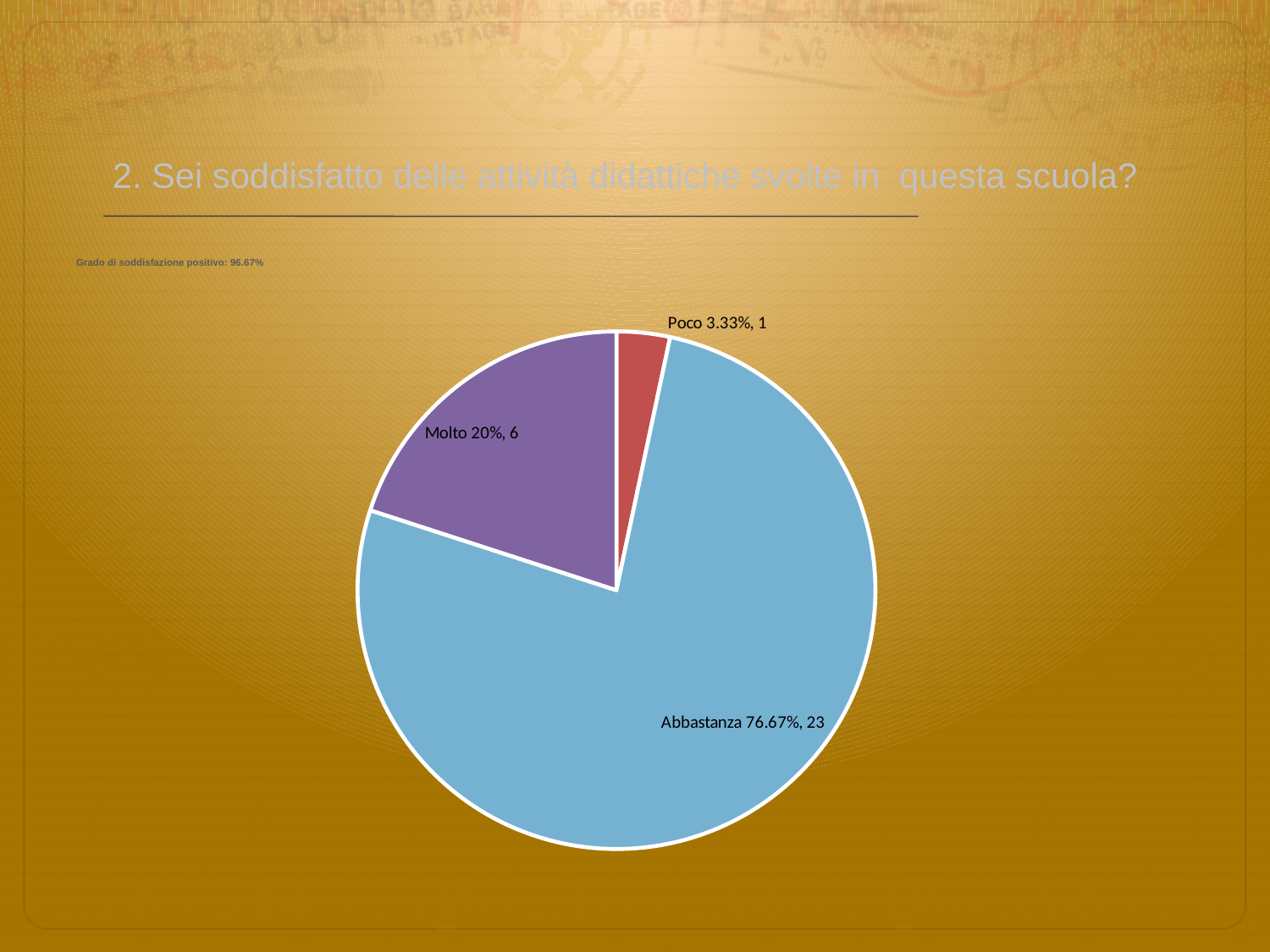
Which category has the largest slice of the pie? Abbastanza What kind of chart is shown on the slide? pie chart How many responses does the Poco slice represent? 1 How many slices does the pie chart have? 3 What percentage share does the Molto slice have? 20% How many responses does the Abbastanza slice represent? 23 What percentage share does the Poco slice have? 3.33% How many responses does the Molto slice represent? 6 Which category has the smallest slice of the pie? Poco What is the difference in number of responses between Abbastanza and Molto? 17 Which slice is larger, Molto or Poco? Molto What percentage share does the Abbastanza slice have? 76.67%